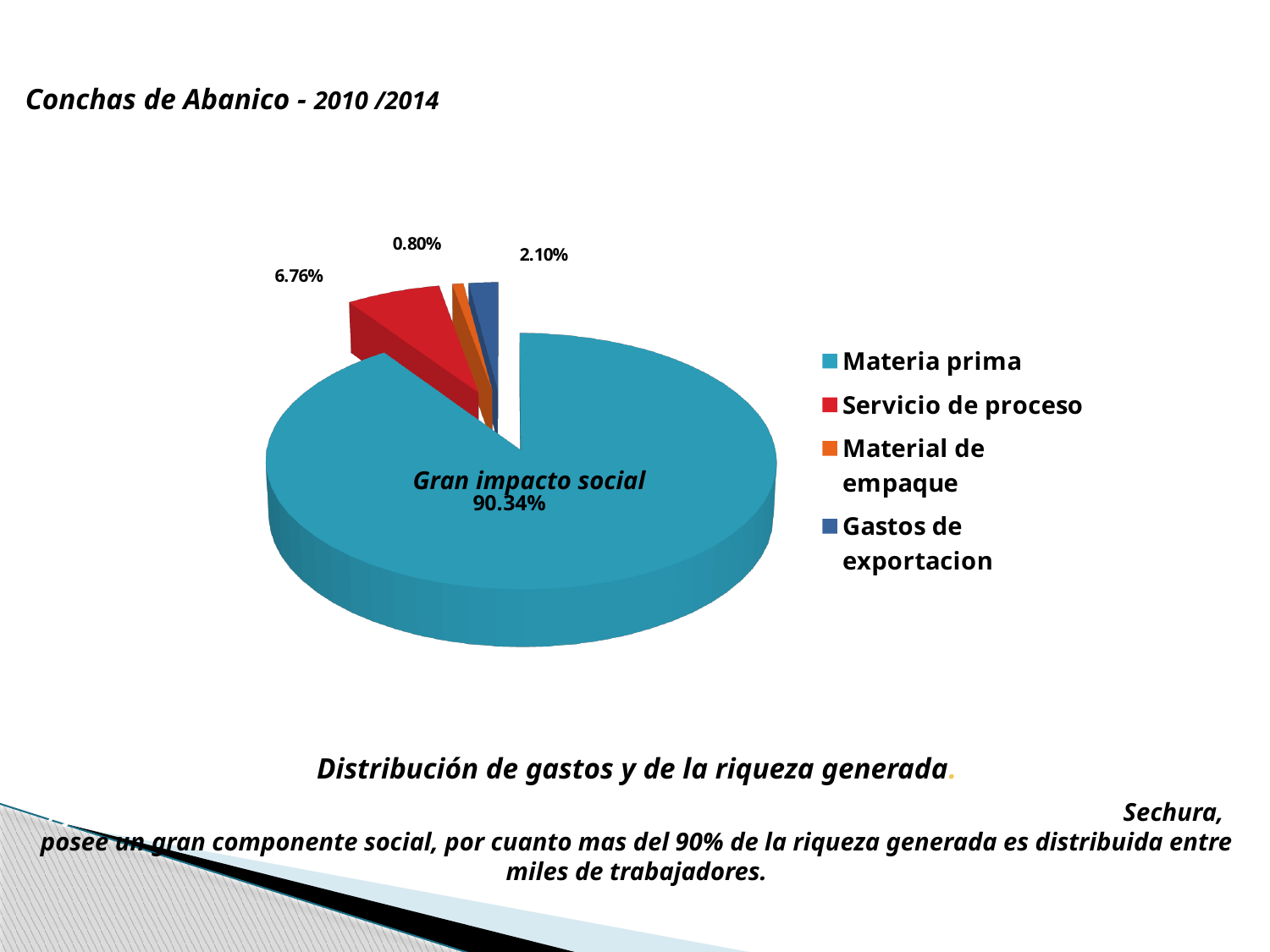
What percentage does the Material de empaque slice represent? 0.80% How many categories does the legend list? 4 Which category has the largest share of the pie? Materia prima What percentage does the Gastos de exportacion slice represent? 2.10% What colour is the Materia prima slice? Teal blue Which is larger, Servicio de proceso or Gastos de exportacion? Servicio de proceso What percentage does the Materia prima slice represent? 90.34% Which category has the smallest share of the pie? Material de empaque What percentage does the Servicio de proceso slice represent? 6.76% What is the difference between the Servicio de proceso share and the Gastos de exportacion share? 4.66% What text is written inside the largest slice of the pie? Gran impacto social What kind of chart is shown on the slide? Pie chart